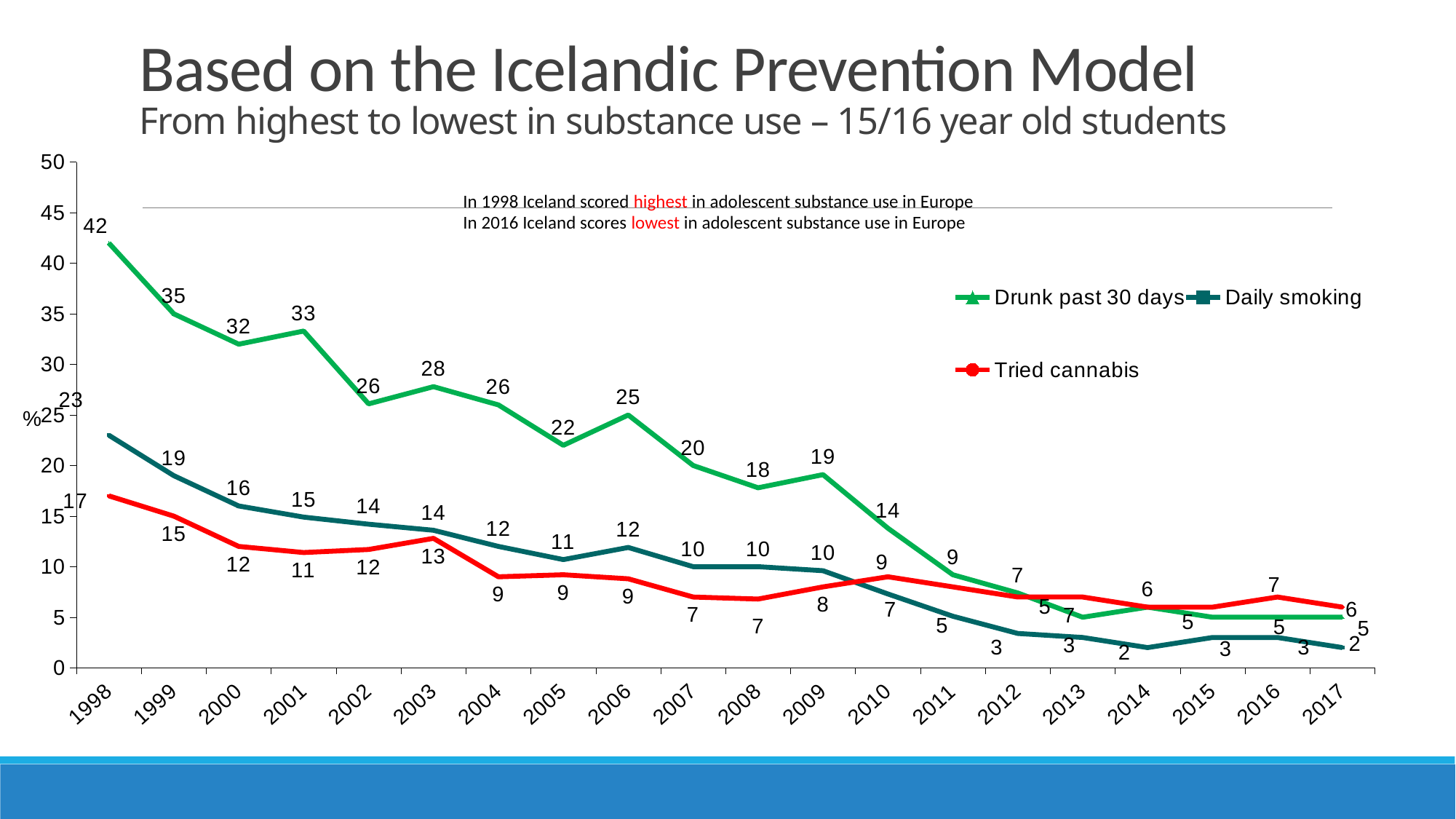
In which year is the Drunk past 30 days series highest? 1998 What is the difference between the Drunk past 30 days value in 1998 and in 2017? 37 How many series does the legend list? 3 What is the value for Drunk past 30 days in 2010? 14 What kind of chart is shown on the slide? Line chart How many years are plotted along the x axis? 20 What is the value for Daily smoking in 1998? 23 What colour is the Tried cannabis line? Red What is the value for Tried cannabis in 1998? 17 What is the value for Drunk past 30 days in 1998? 42 In 2005, which is larger: Drunk past 30 days or Daily smoking? Drunk past 30 days Does the Drunk past 30 days series generally rise or fall from 1998 to 2017? Fall